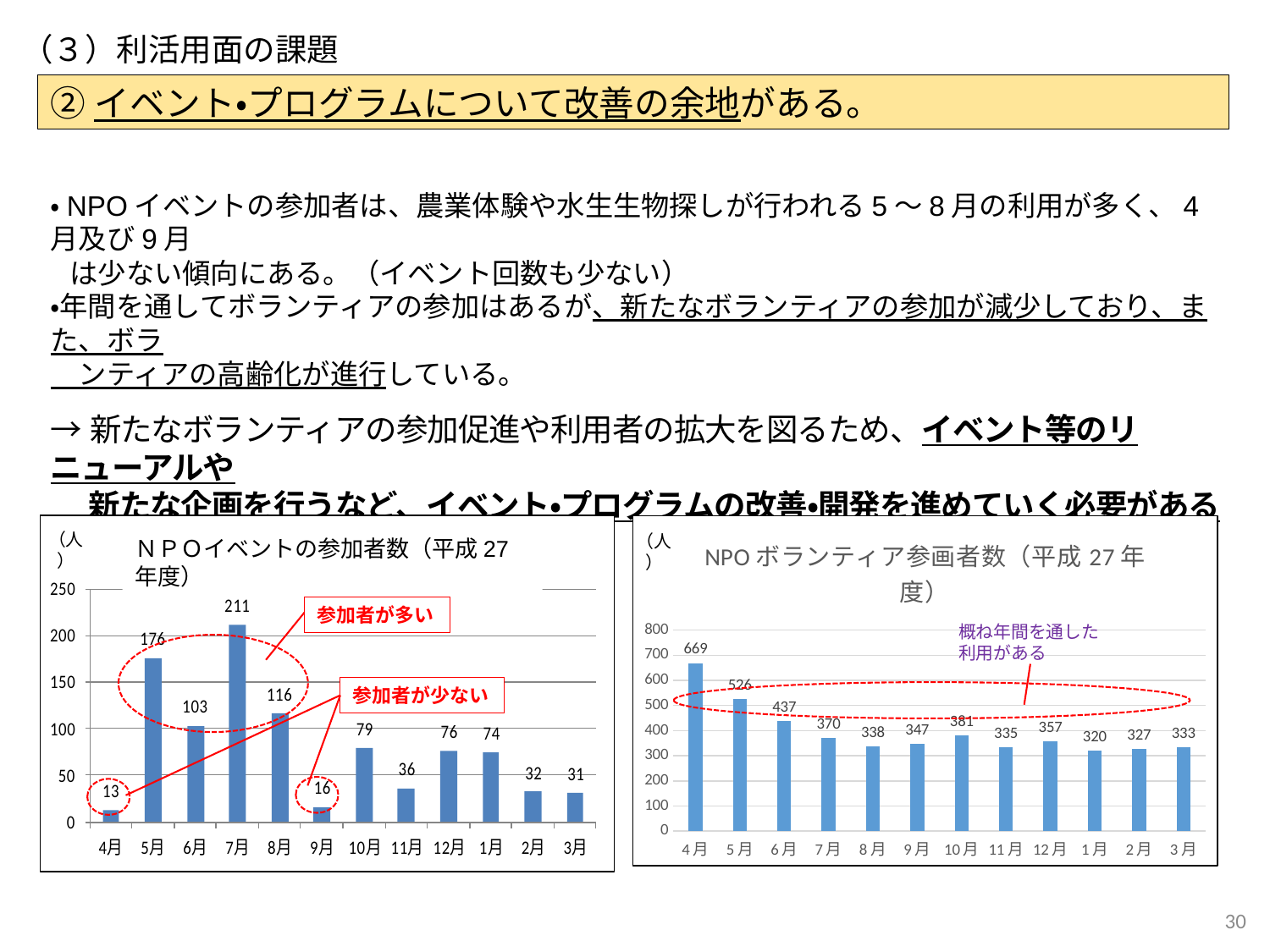
What type of chart is the right chart (NPOボランティア参画者数)? Bar chart In the right chart (NPOボランティア参画者数), which is larger, the value for 5月 or the value for 6月? 5月 In the left chart (ＮＰＯイベントの参加者数), how many months are shown on the x axis? 12 In the left chart (ＮＰＯイベントの参加者数), what is the value for 7月? 211 In the right chart (NPOボランティア参画者数), what is the difference between the values for 4月 and 5月? 143 In the right chart (NPOボランティア参画者数), which month has the lowest value? 1月 In the right chart (NPOボランティア参画者数), what is the value for 10月? 381 In the left chart (ＮＰＯイベントの参加者数), what is the difference between the values for 5月 and 6月? 73 In the left chart (ＮＰＯイベントの参加者数), what is the value for 4月? 13 In the right chart (NPOボランティア参画者数), what is the value for 4月? 669 In the left chart (ＮＰＯイベントの参加者数), which month has the lowest value? 4月 In the left chart (ＮＰＯイベントの参加者数), which month has the highest value? 7月